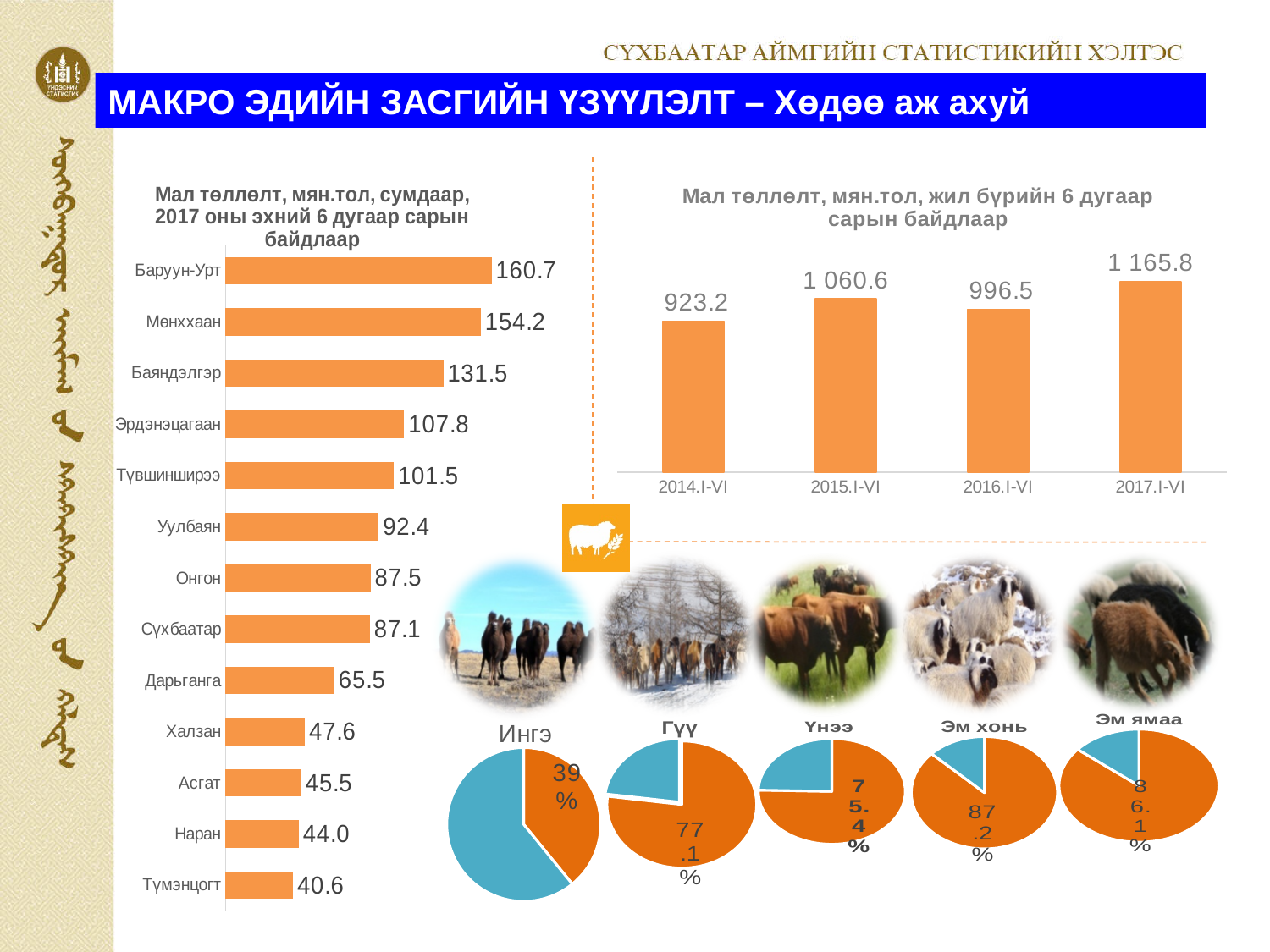
In the left bar chart by soum, which is larger, Онгон or Сүхбаатар? Онгон How many soums are shown in the left bar chart? 13 In the left bar chart by soum, which soum has the highest value? Баруун-Урт In the top-right chart by year, which period has the highest value? 2017.I-VI In the top-right chart by year, what is the difference between 2017.I-VI and 2016.I-VI? 169.3 In the pie chart titled 'Ингэ', what percentage is labelled on the orange slice? 39% In the pie chart titled 'Эм хонь', what share is shown for the orange slice? 87.2% What kind of chart is the left chart showing values by soum? Bar chart In the left bar chart by soum, which soum has the lowest value? Түмэнцогт In the top-right chart 'Мал төллөлт, мян.тол, жил бүрийн 6 дугаар сарын байдлаар', what is the value for 2015.I-VI? 1 060.6 In the left bar chart by soum, what is the difference between Мөнххаан and Баяндэлгэр? 22.7 In the left bar chart 'Мал төллөлт, мян.тол, сумдаар, 2017 оны эхний 6 дугаар сарын байдлаар', what is the value for Баруун-Урт? 160.7